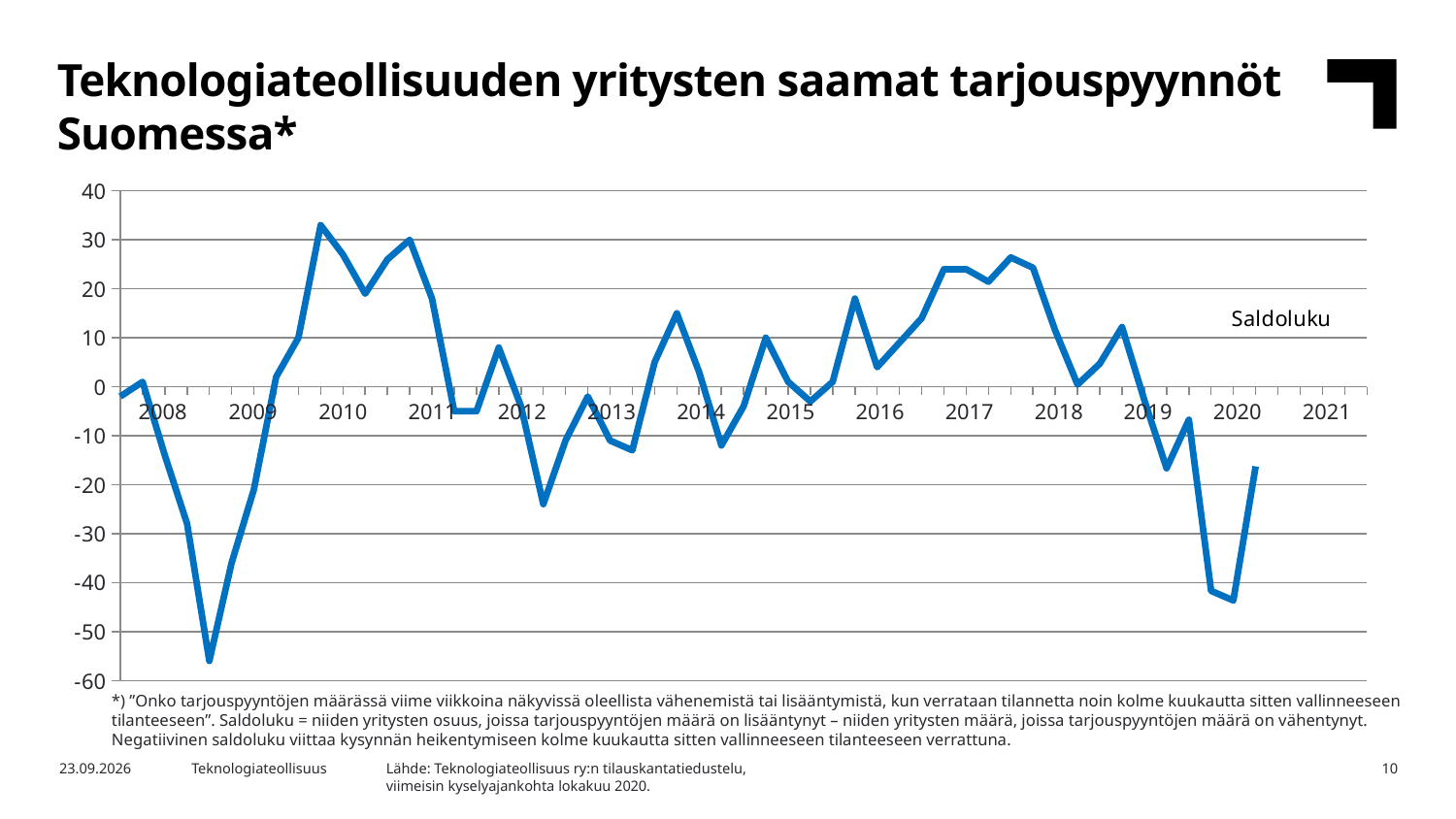
How many year labels are shown on the x axis? 14 What is the name of the series plotted in the chart? Saldoluku Is the peak value of the line in 2010 greater or less than 30? greater Is the lowest value of the line in 2020 greater or less than -40? less Is the lowest value of the line in 2009 greater or less than -50? less What is the title of the chart on the slide? Teknologiateollisuuden yritysten saamat tarjouspyynnöt Suomessa* What kind of chart is shown on the slide? line chart In which year does the line reach its lowest point? 2009 Does the line rise or fall between the 2018 peak and the 2020 low? fall How many series does the chart show? 1